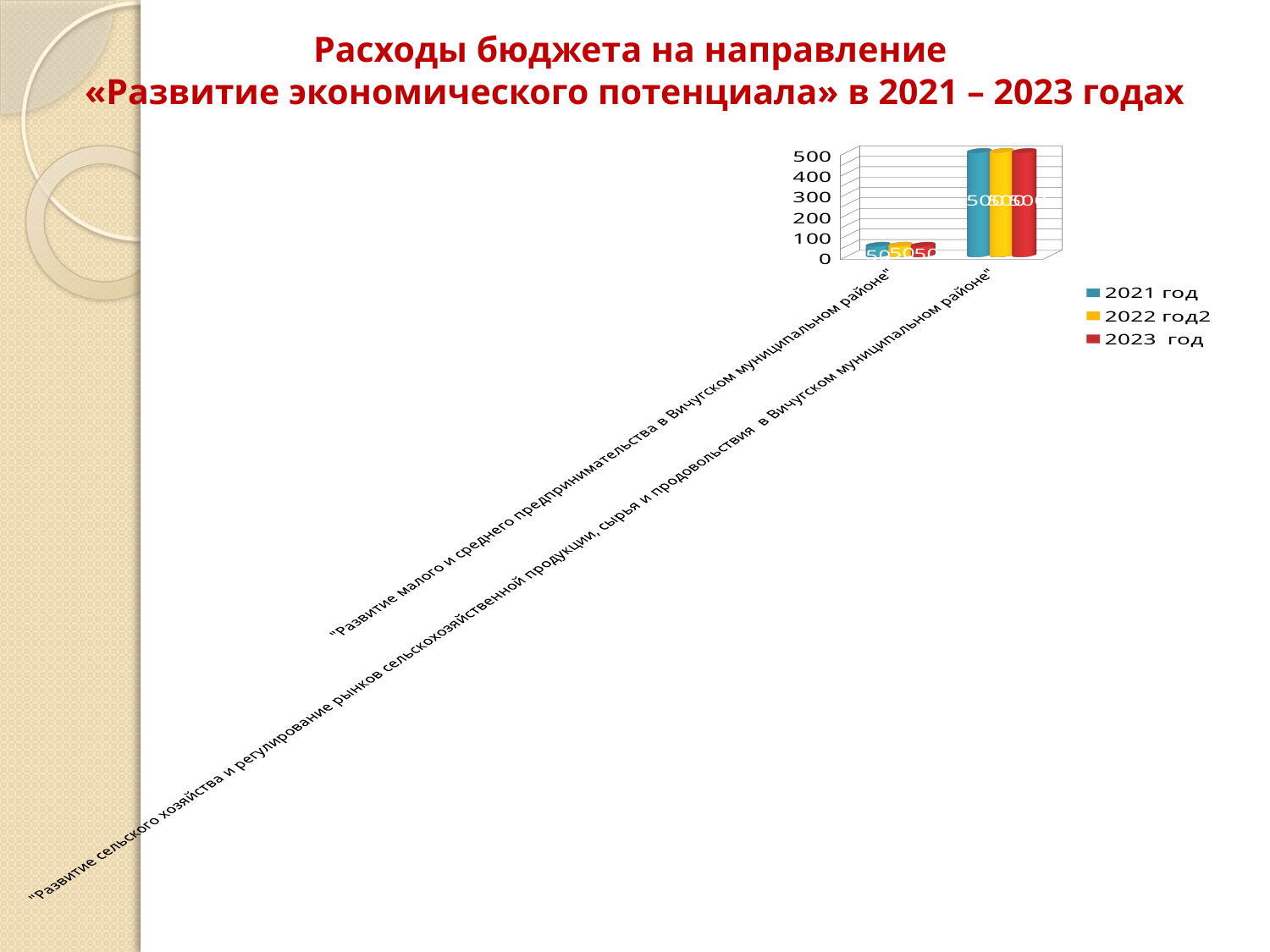
How many series does the legend list? 3 Which category has the lowest values in the chart? "Развитие малого и среднего предпринимательства в Вичугском муниципальном районе" Which series are listed in the chart legend? 2021 год, 2022 год2, 2023 год Is the value for 2022 год2 in the category "Развитие малого и среднего предпринимательства в Вичугском муниципальном районе" greater or less than 100? less What kind of chart is shown on the slide? bar chart What is the value for 2023 год in the category "Развитие сельского хозяйства и регулирование рынков сельскохозяйственной продукции, сырья и продовольствия в Вичугском муниципальном районе"? 500 How many categories are shown on the x axis of the chart? 2 Which category has the highest values in the chart? "Развитие сельского хозяйства и регулирование рынков сельскохозяйственной продукции, сырья и продовольствия в Вичугском муниципальном районе" Is the value for 2021 год in the category "Развитие сельского хозяйства и регулирование рынков сельскохозяйственной продукции, сырья и продовольствия в Вичугском муниципальном районе" greater or less than 400? greater What is the value for 2021 год in the category "Развитие сельского хозяйства и регулирование рынков сельскохозяйственной продукции, сырья и продовольствия в Вичугском муниципальном районе"? 500 What colour represents the series 2022 год2 in the chart? yellow Which is larger for 2023 год: the value for "Развитие малого и среднего предпринимательства в Вичугском муниципальном районе" or for "Развитие сельского хозяйства и регулирование рынков сельскохозяйственной продукции, сырья и продовольствия в Вичугском муниципальном районе"? "Развитие сельского хозяйства и регулирование рынков сельскохозяйственной продукции, сырья и продовольствия в Вичугском муниципальном районе"